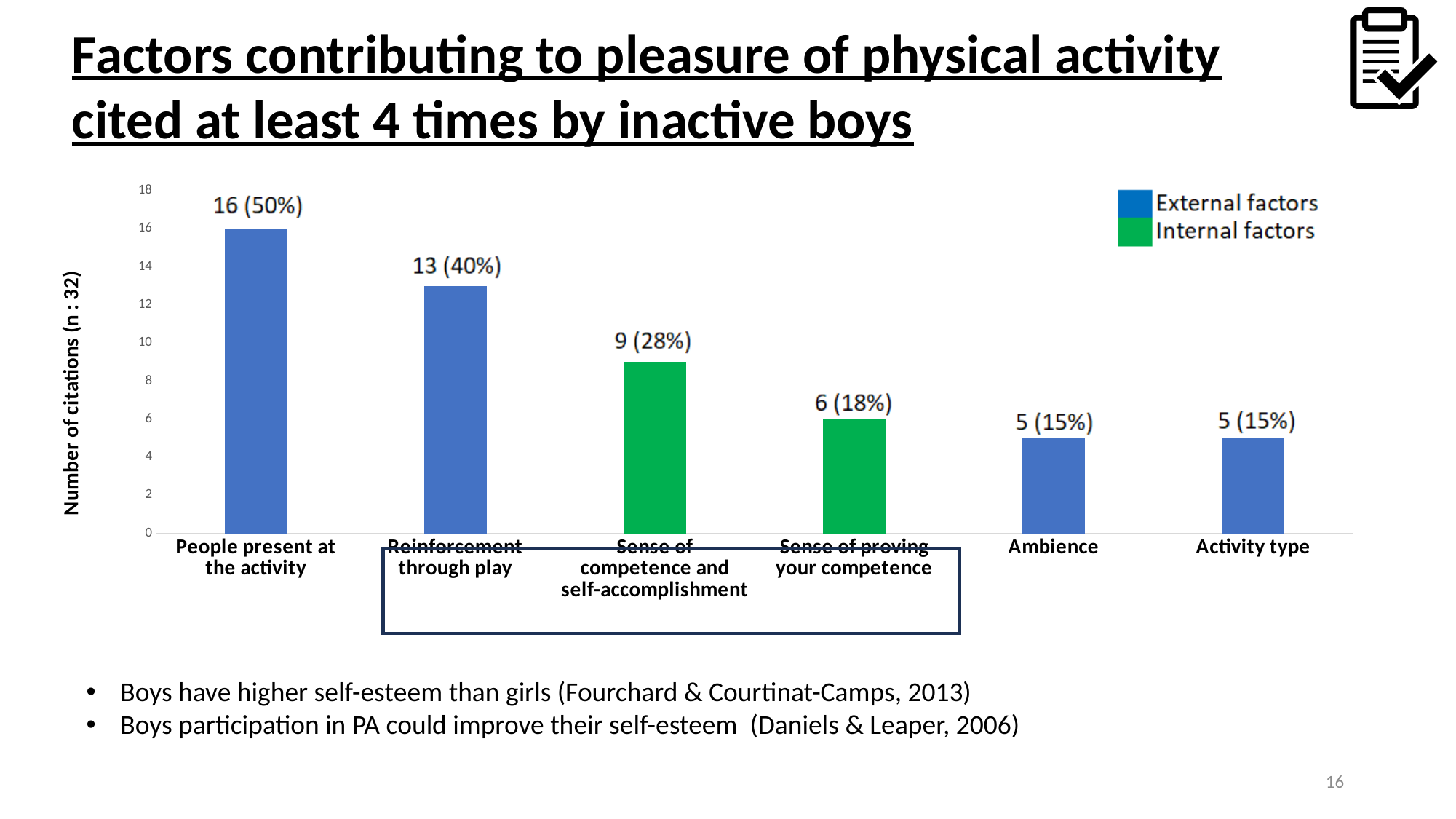
What is the number of citations for 'People present at the activity'? 16 (50%) What is the number of citations for 'Ambience'? 5 (15%) Which colour represents 'Internal factors' in the legend? Green What is the number of citations for 'Sense of competence and self-accomplishment'? 9 (28%) What is the difference in number of citations between 'People present at the activity' and 'Reinforcement through play'? 3 Which has more citations, 'Reinforcement through play' or 'Sense of proving your competence'? Reinforcement through play Which factor has the highest number of citations? People present at the activity Do the values rise or fall from left to right along the x axis? Fall What is the difference in number of citations between 'Sense of competence and self-accomplishment' and 'Sense of proving your competence'? 3 How many factors (categories) are shown on the chart? 6 What kind of chart is shown on the slide? Bar chart How many series does the legend list? 2